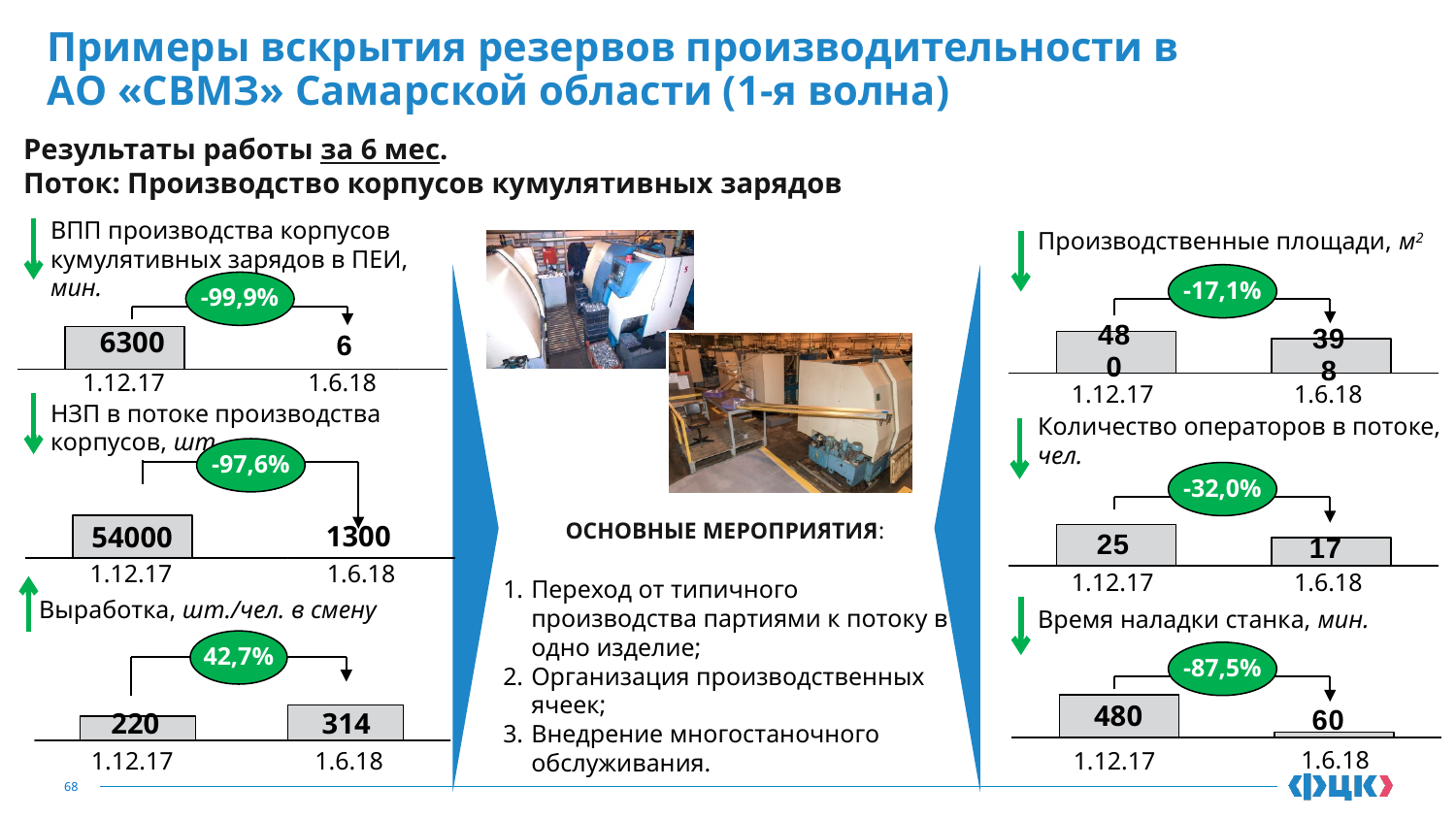
On the chart 'Выработка, шт./чел. в смену', what is the difference between the 1.6.18 value and the 1.12.17 value? 94 On the chart 'Выработка, шт./чел. в смену', what is the value for 1.6.18? 314 On the chart 'Количество операторов в потоке, чел.', what is the value for 1.6.18? 17 On the chart 'Выработка, шт./чел. в смену', do the values rise or fall from 1.12.17 to 1.6.18? rise What kind of chart is 'Время наладки станка, мин.'? bar chart On the chart 'Производственные площади, м²', what percentage change is shown between 1.12.17 and 1.6.18? -17,1% On the chart 'ВПП производства корпусов кумулятивных зарядов в ПЕИ, мин.', what is the value for 1.12.17? 6300 On the chart 'НЗП в потоке производства корпусов, шт.', what is the value for 1.12.17? 54000 On the chart 'ВПП производства корпусов кумулятивных зарядов в ПЕИ, мин.', what is the value for 1.6.18? 6 On the chart 'Количество операторов в потоке, чел.', what is the difference between the 1.12.17 value and the 1.6.18 value? 8 On the chart 'Время наладки станка, мин.', which date has the higher value, 1.12.17 or 1.6.18? 1.12.17 On the chart 'НЗП в потоке производства корпусов, шт.', what percentage change is shown between 1.12.17 and 1.6.18? -97,6%